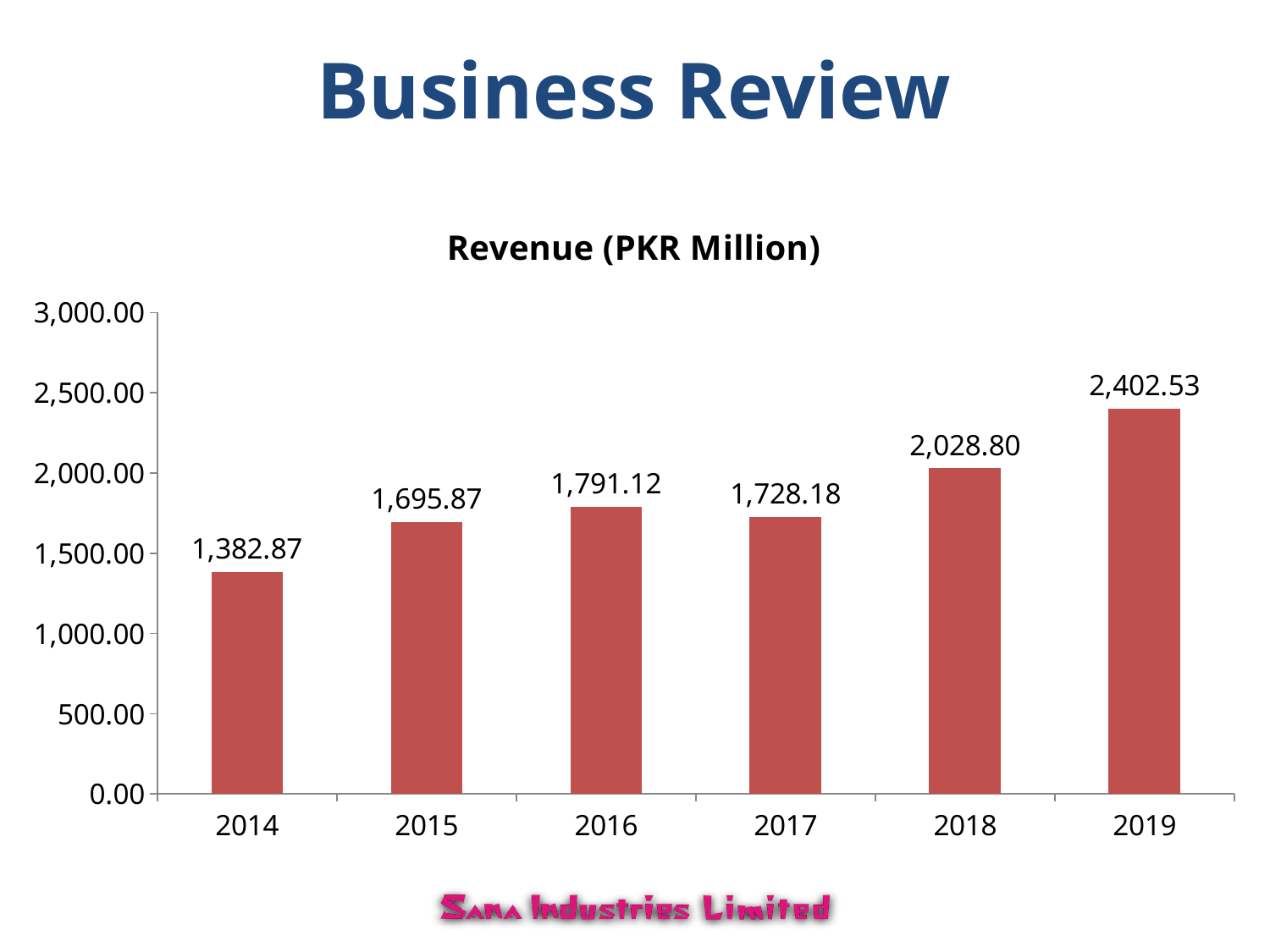
How many years are shown on the chart? 6 What is the title of the chart? Revenue (PKR Million) Which year has the highest revenue? 2019 What is the difference in revenue between 2019 and 2018? 373.73 Which year has the lowest revenue? 2014 What kind of chart is shown on the slide? bar chart What is the difference in revenue between 2016 and 2017? 62.94 What is the revenue for 2019? 2,402.53 Is the revenue for 2018 greater or less than 2,000.00? greater What is the revenue for 2014? 1,382.87 Which year has higher revenue, 2016 or 2017? 2016 What is the revenue for 2017? 1,728.18